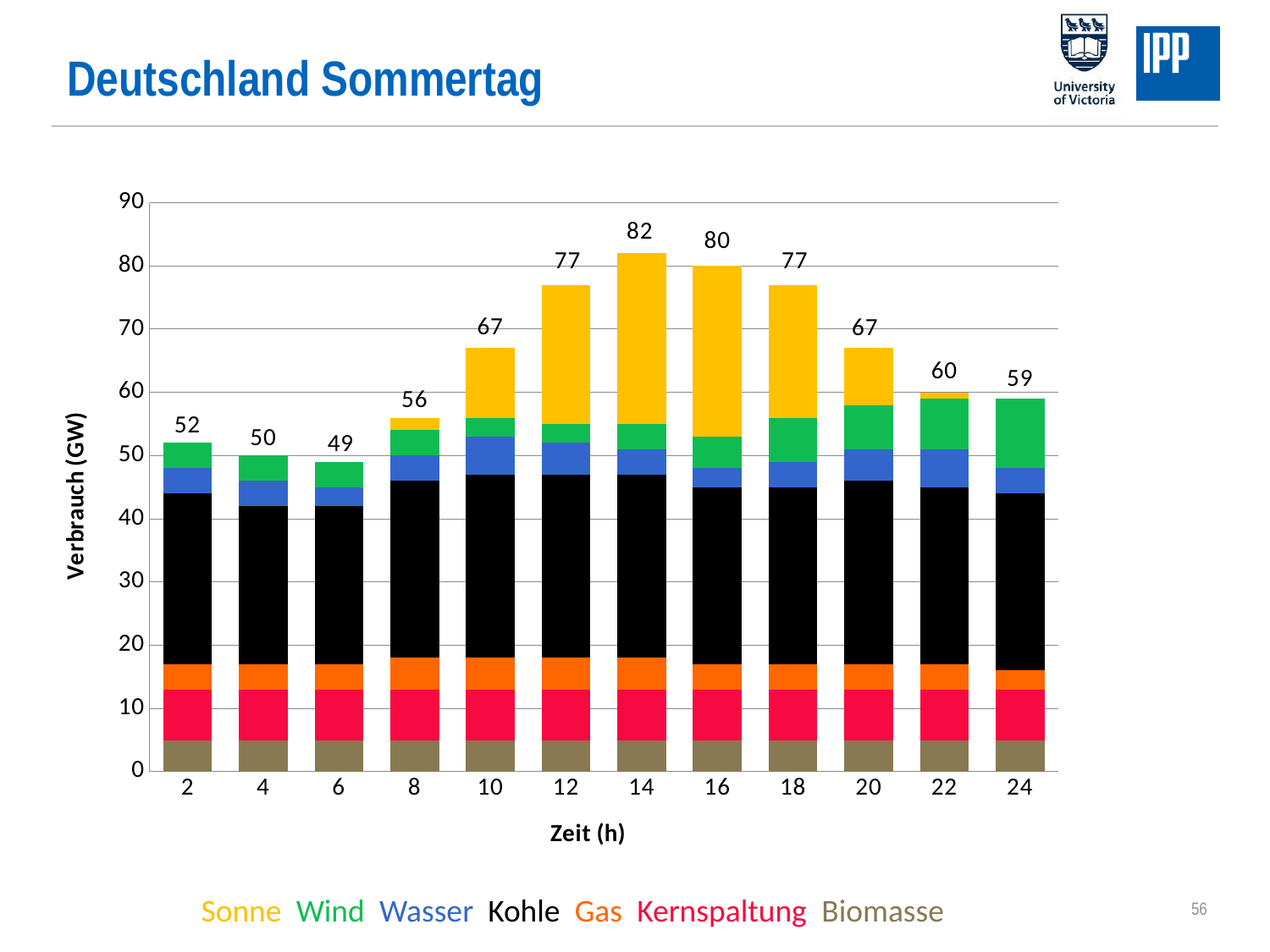
How many bars (time points) are shown on the x axis? 12 What is the difference between the highest total (at 14 h) and the lowest total (at 6 h)? 33 What kind of chart is shown on the slide? Stacked bar chart Which colour represents Sonne in the legend? Yellow How many series does the legend list? 7 Which has a larger total, the bar at 16 h or the bar at 18 h? 16 h At which hour is the total consumption highest? 14 At which hour is the total consumption lowest? 6 What is the total value of the bar at 8 h? 56 What is the total value of the bar at 22 h? 60 What is the total value of the bar at 14 h? 82 Do the total values rise or fall from 2 h to 14 h? Rise